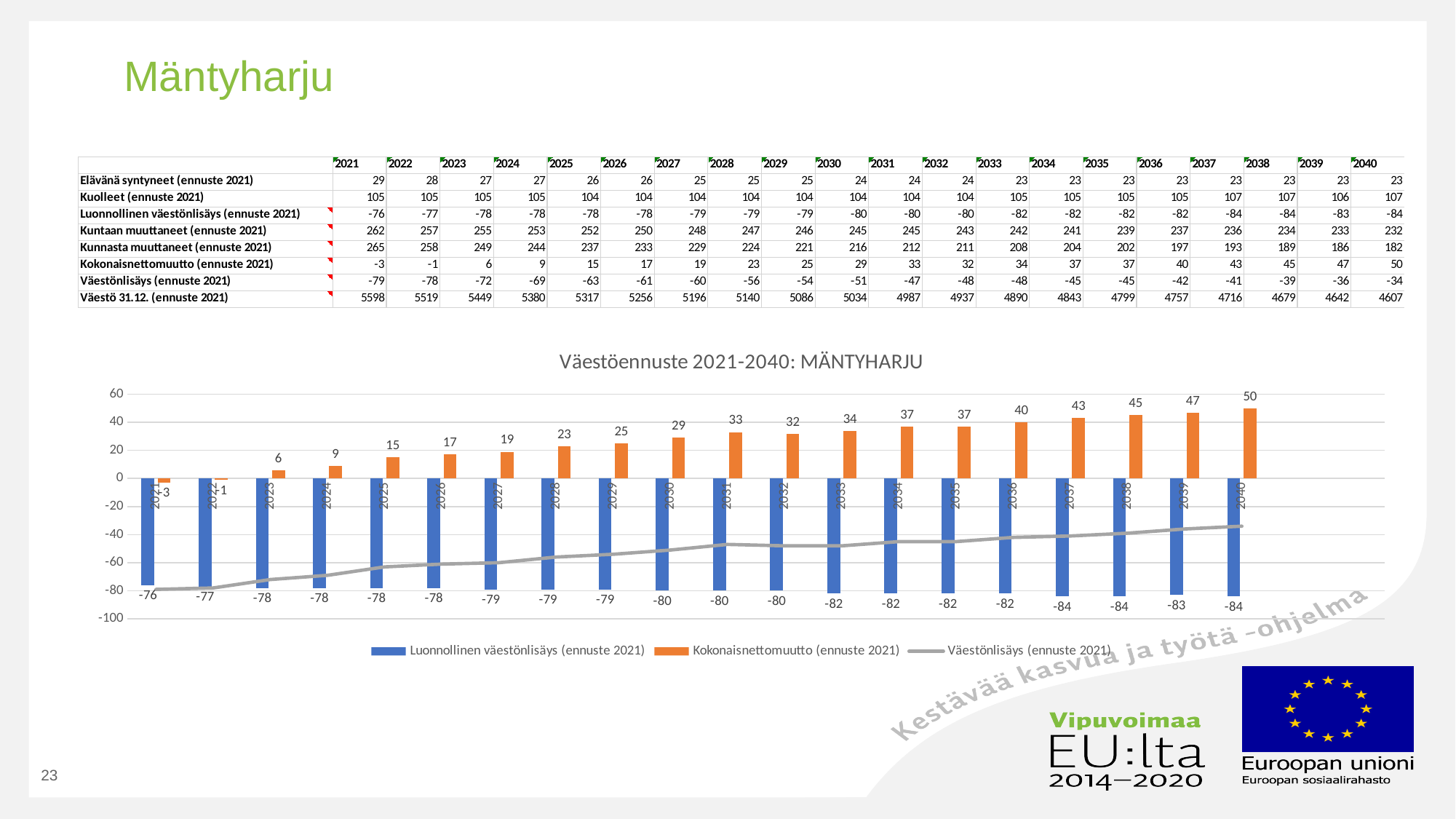
How many years are shown on the x axis of the chart? 20 Is the Väestönlisäys (ennuste 2021) line value for 2040 greater or less than -40? greater What is the title of the chart? Väestöennuste 2021-2040: MÄNTYHARJU In which year is Kokonaisnettomuutto (ennuste 2021) highest? 2040 Does Kokonaisnettomuutto (ennuste 2021) generally rise or fall from 2021 to 2040? rise How many series does the chart legend list? 3 What is the difference between Kokonaisnettomuutto (ennuste 2021) in 2040 and in 2023? 44 What kind of chart is used for the Kokonaisnettomuutto (ennuste 2021) series? bar chart Which is larger, Kokonaisnettomuutto (ennuste 2021) in 2031 or in 2032? 2031 What is the value of Kokonaisnettomuutto (ennuste 2021) for 2030? 29 In which year is Kokonaisnettomuutto (ennuste 2021) lowest? 2021 What is the value of Luonnollinen väestönlisäys (ennuste 2021) for 2021? -76